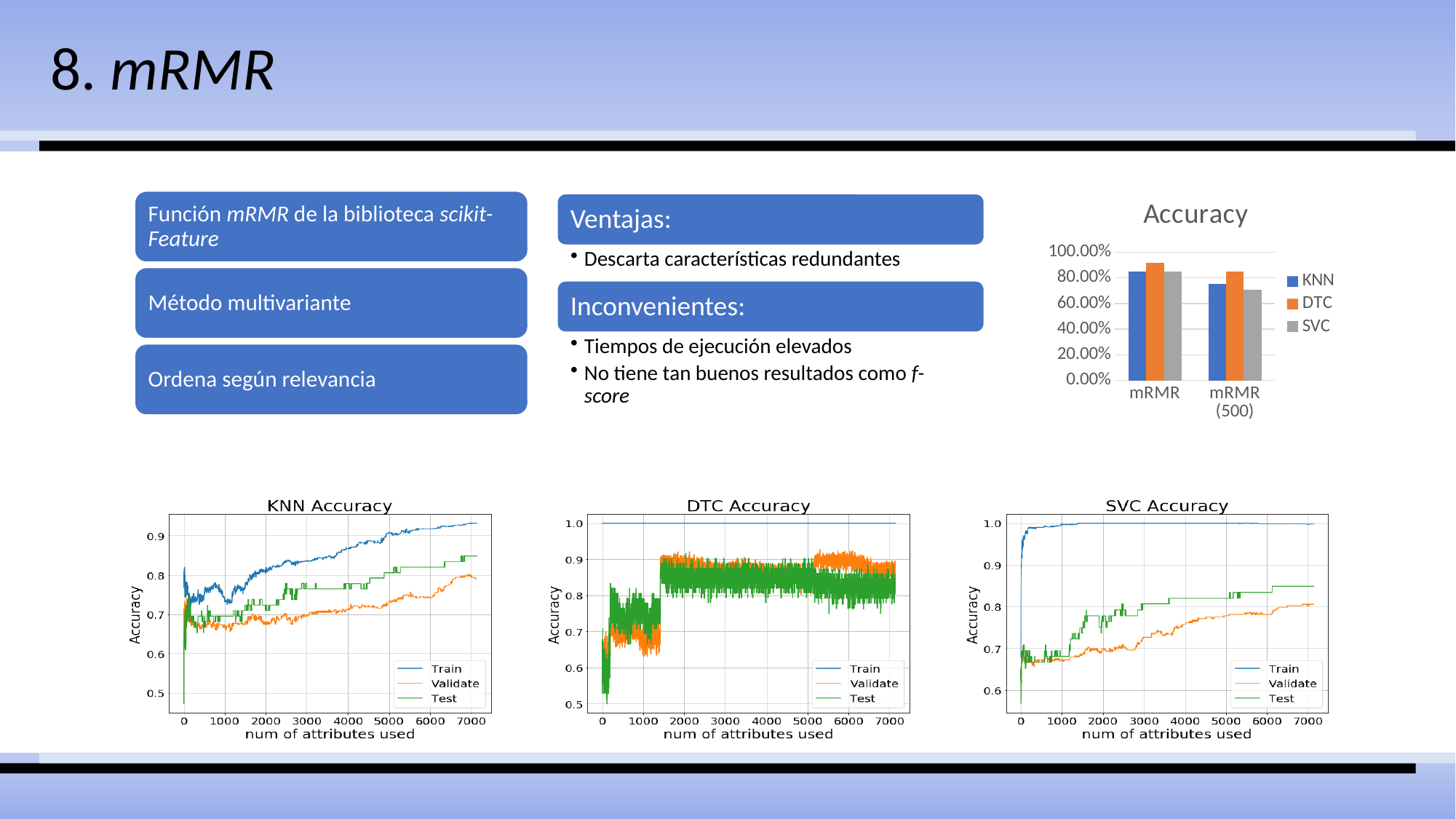
How many categories are shown on the x axis of the Accuracy bar chart? 2 In the Accuracy bar chart, which series has the highest value for the mRMR category? DTC In the SVC Accuracy chart, is the Test line at 7000 attributes greater or less than 0.8? greater What are the three legend entries in the KNN Accuracy chart? Train, Validate, Test How many series does the legend of the Accuracy bar chart list? 3 What kind of chart is the Accuracy chart at the top right of the slide? bar chart In the Accuracy bar chart, which is larger for mRMR (500): the KNN value or the DTC value? DTC In the DTC Accuracy chart, at what accuracy value does the Train line stay across the whole x axis? 1.0 In the Accuracy bar chart, is the SVC value for mRMR (500) greater or less than 80.00%? less In the KNN Accuracy chart, does the Train line rise or fall as the number of attributes used increases? rise In the Accuracy bar chart, is the DTC value for mRMR greater or less than 80.00%? greater In the Accuracy bar chart, which series has the lowest value for the mRMR (500) category? SVC